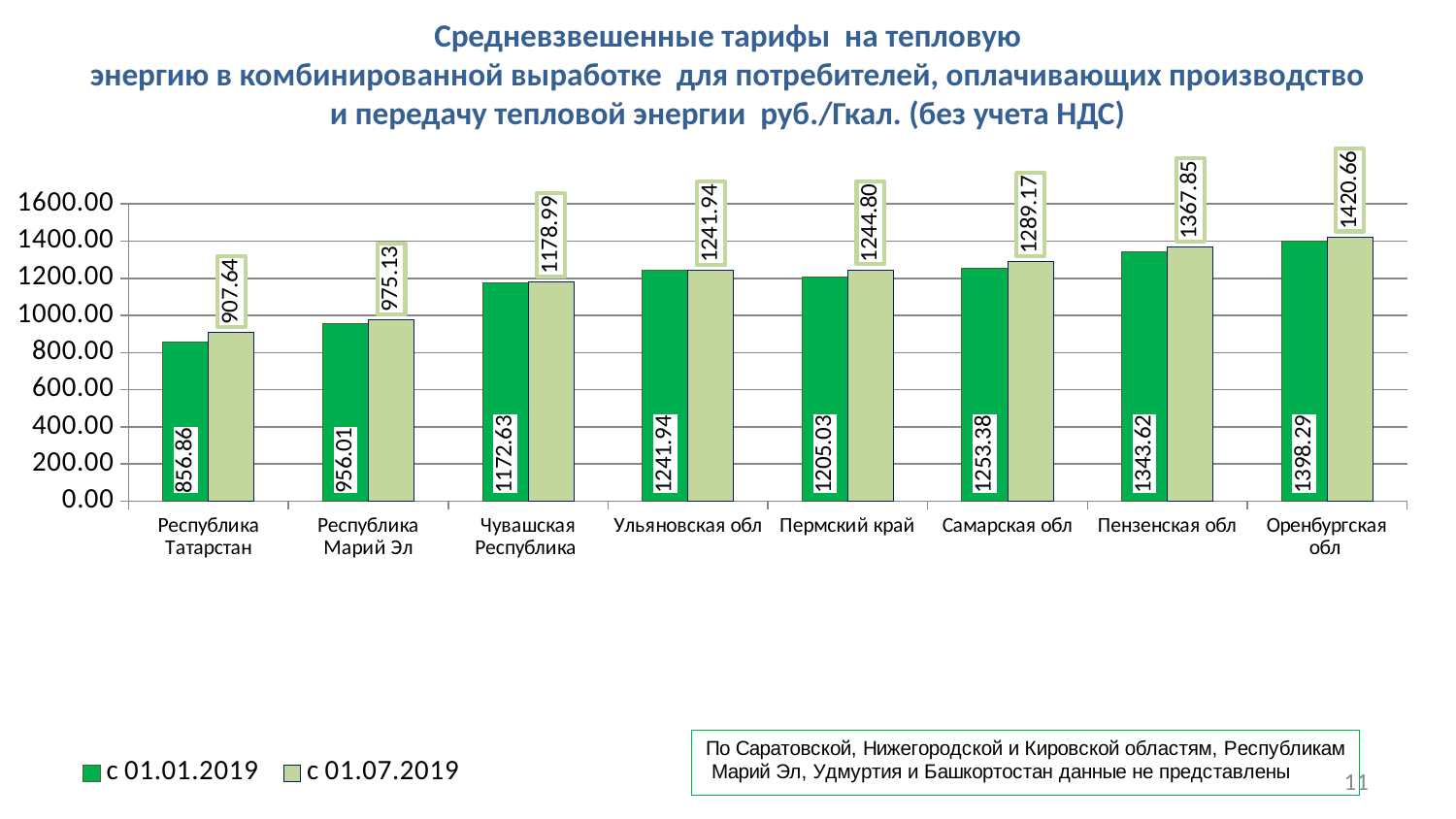
Which is larger: the с 01.01.2019 value for Пензенская обл or the с 01.01.2019 value for Самарская обл? Пензенская обл Which category has the highest value in the с 01.07.2019 series? Оренбургская обл What is the value for Оренбургская обл in the с 01.07.2019 series? 1420.66 What is the value for Пермский край in the с 01.07.2019 series? 1244.80 How many categories are shown on the x axis? 8 What is the value for Республика Татарстан in the с 01.01.2019 series? 856.86 What is the difference between the с 01.07.2019 and с 01.01.2019 values for Самарская обл? 35.79 Which category has the lowest value in the с 01.01.2019 series? Республика Татарстан Is the с 01.01.2019 value for Чувашская Республика greater or less than 1000.00? greater What kind of chart is shown on the slide? bar chart Do the с 01.07.2019 values generally rise or fall from left to right along the x axis? rise How many series does the legend list? 2